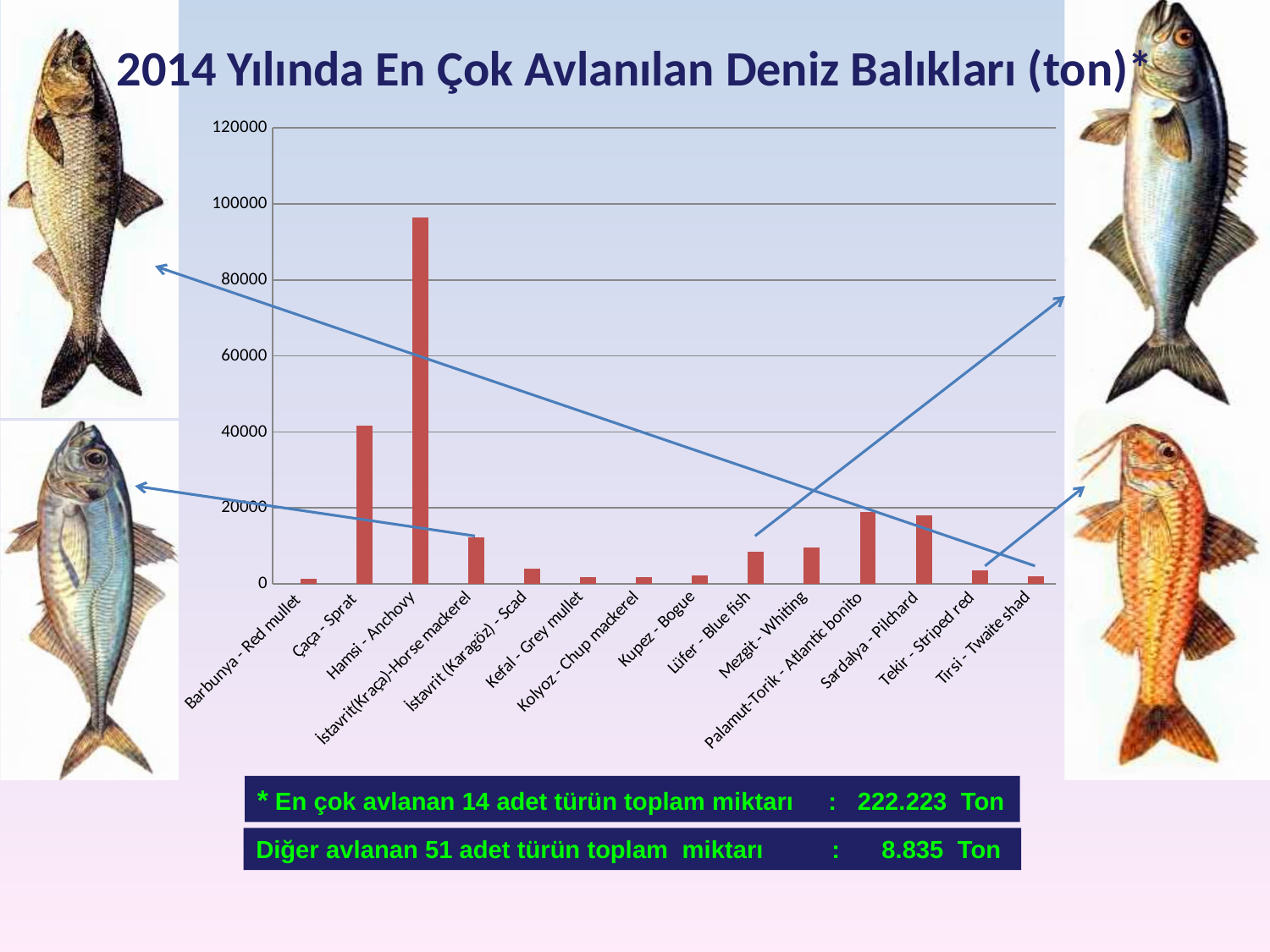
Is the value for Çaça - Sprat greater or less than 20000? greater Which has a larger value, Çaça - Sprat or Hamsi - Anchovy? Hamsi - Anchovy Which has a larger value, Palamut-Torik - Atlantic bonito or Lüfer - Blue fish? Palamut-Torik - Atlantic bonito Is the value for İstavrit(Kraça)-Horse mackerel greater or less than 20000? less Is the value for Lüfer - Blue fish greater or less than 20000? less How many fish species (categories) are plotted on the chart? 14 What is the title of the chart on the slide? 2014 Yılında En Çok Avlanılan Deniz Balıkları (ton) What is the highest value shown on the vertical axis of the chart? 120000 What kind of chart is shown on the slide? bar chart Which fish species has the highest catch value on the chart? Hamsi - Anchovy